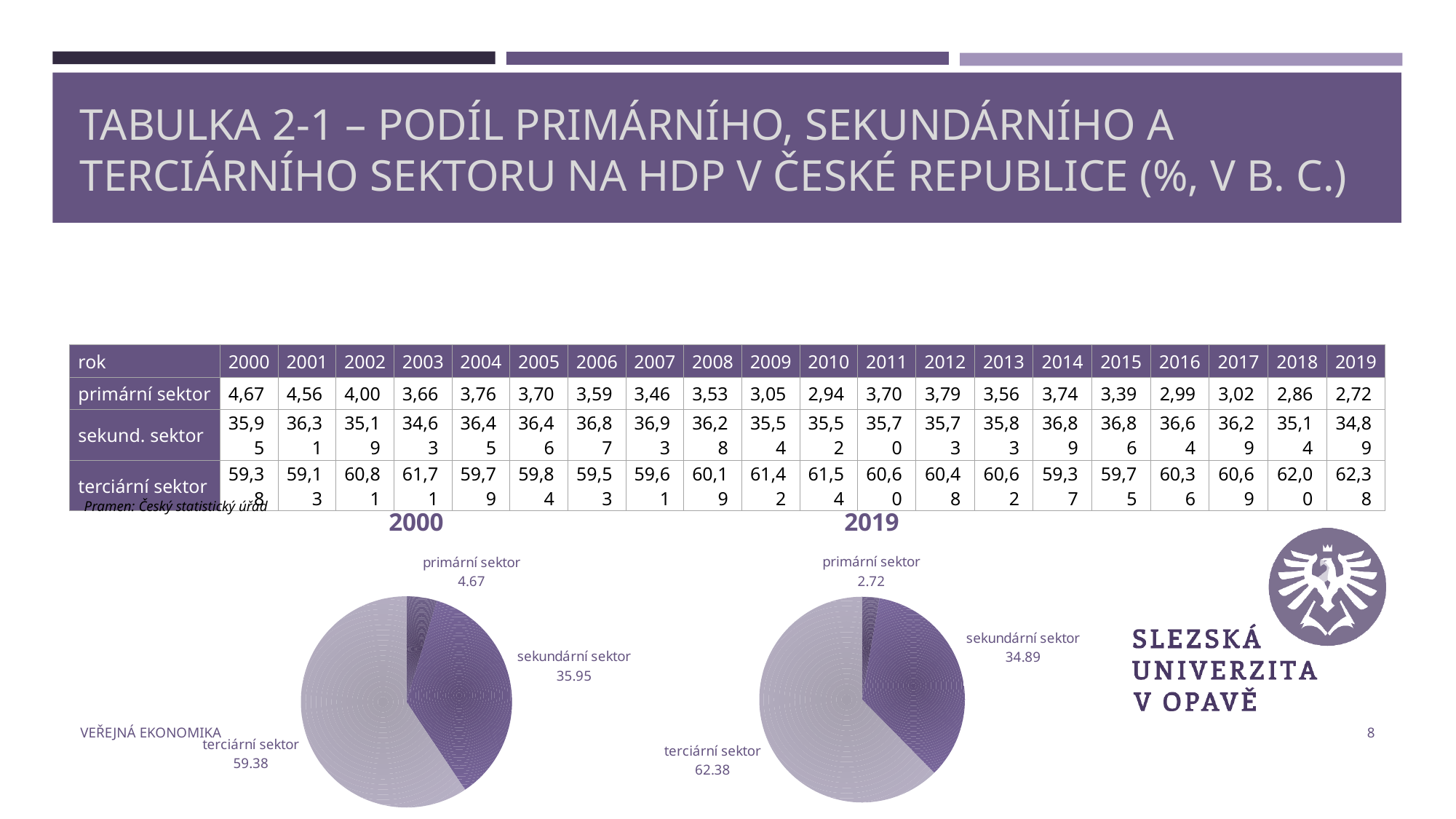
How many slices does the pie chart titled 2019 have? 3 In the pie chart titled 2019, which sector has the smallest slice? primární sektor What type of chart is used for the 2000 and 2019 charts on the slide? pie chart In the pie chart titled 2019, what share of the pie does sekundární sektor represent? 34.89 In the pie chart titled 2019, what is the value for terciární sektor? 62.38 In the pie chart titled 2000, what is the difference between the terciární sektor and sekundární sektor values? 23.43 What are the titles of the two pie charts on the slide? 2000 and 2019 What is the difference between the primární sektor value in the 2000 pie chart and the primární sektor value in the 2019 pie chart? 1.95 Which is larger: the terciární sektor value in the 2000 pie chart or in the 2019 pie chart? 2019 In the pie chart titled 2000, what is the value for sekundární sektor? 35.95 In the pie chart titled 2019, what is the value for primární sektor? 2.72 In the pie chart titled 2000, which sector has the largest slice? terciární sektor